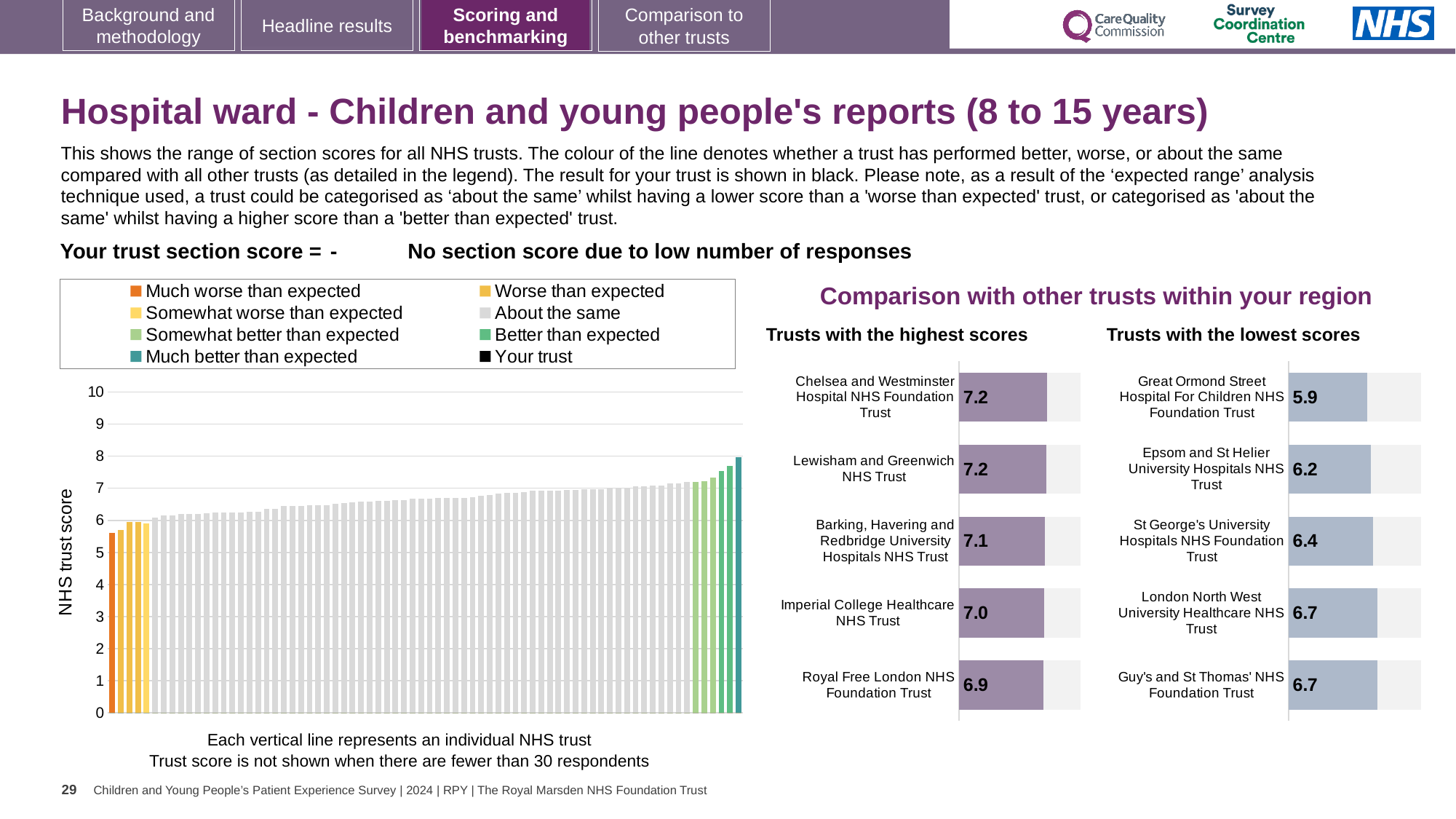
In the 'Trusts with the lowest scores' chart, which trust has the lowest score? Great Ormond Street Hospital For Children NHS Foundation Trust How many entries does the legend of the left-hand NHS trust score chart list? 8 In the left-hand chart of NHS trust scores, is the value of the leftmost (orange) bar greater or less than 6? less In the 'Trusts with the highest scores' chart, what is the difference between the score for Chelsea and Westminster Hospital NHS Foundation Trust and the score for Royal Free London NHS Foundation Trust? 0.3 How many trusts are shown in the 'Trusts with the highest scores' chart? 5 In the left-hand chart of NHS trust scores, do the bar values rise or fall from left to right? rise In the 'Trusts with the lowest scores' chart, what is the score for Great Ormond Street Hospital For Children NHS Foundation Trust? 5.9 In the 'Trusts with the highest scores' chart, what is the score for Royal Free London NHS Foundation Trust? 6.9 Which is larger: the score for Barking, Havering and Redbridge University Hospitals NHS Trust in the highest scores chart, or the score for London North West University Healthcare NHS Trust in the lowest scores chart? Barking, Havering and Redbridge University Hospitals NHS Trust In the 'Trusts with the lowest scores' chart, what is the difference between the score for Epsom and St Helier University Hospitals NHS Trust and the score for Great Ormond Street Hospital For Children NHS Foundation Trust? 0.3 In the 'Trusts with the highest scores' chart, what is the score for Imperial College Healthcare NHS Trust? 7.0 In the 'Trusts with the lowest scores' chart, what is the score for St George's University Hospitals NHS Foundation Trust? 6.4